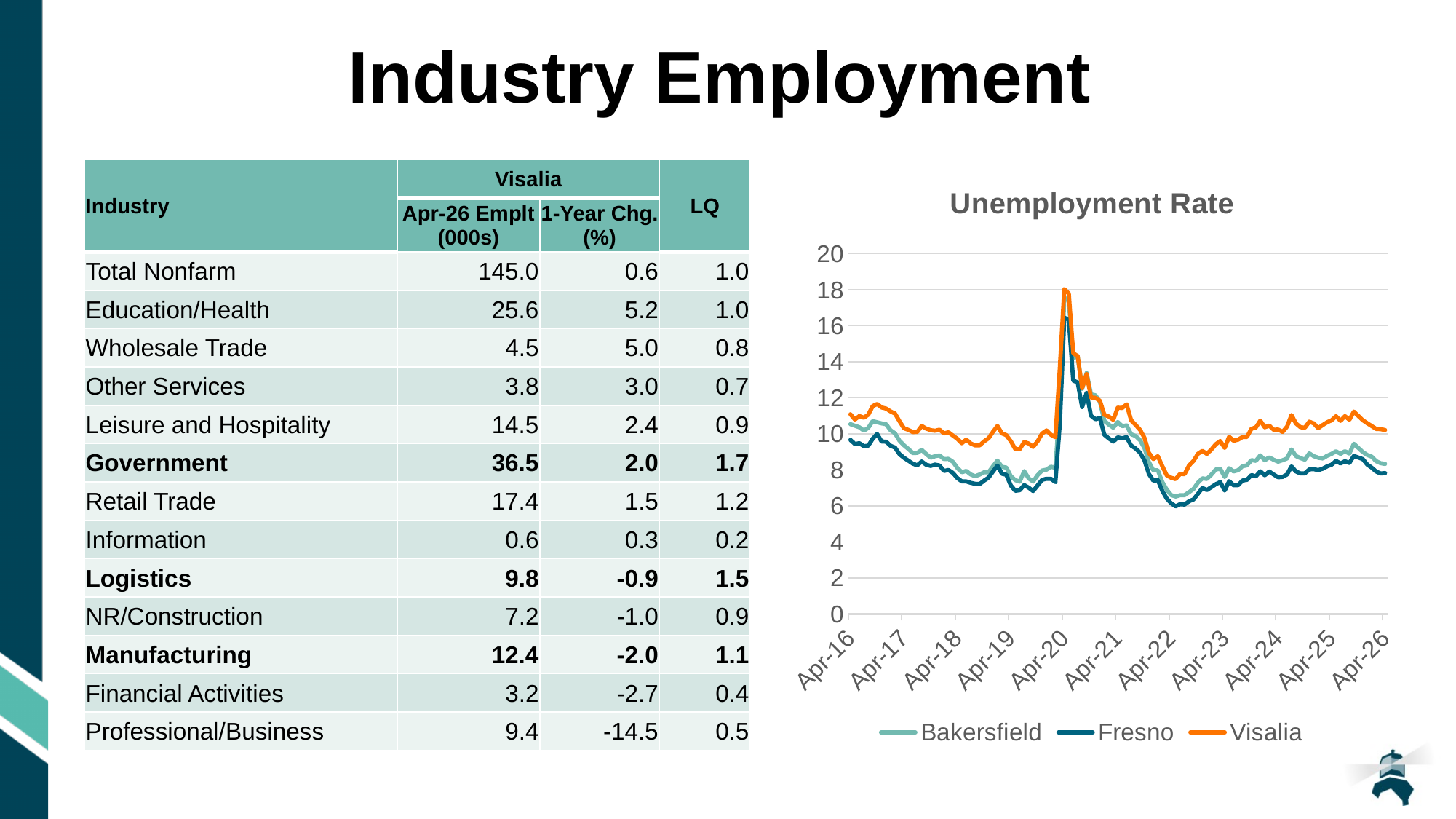
What is the title of the chart on the right of the slide? Unemployment Rate In the Unemployment Rate chart, which series has the highest value at Apr-26? Visalia Which series are listed in the legend of the Unemployment Rate chart? Bakersfield, Fresno, Visalia In the Unemployment Rate chart, is the value for Fresno at Apr-22 greater or less than 8? less In the Unemployment Rate chart, do the values rise or fall between the Apr-20 peak and Apr-22? fall How many date labels are shown on the x axis of the Unemployment Rate chart? 11 How many series does the legend of the Unemployment Rate chart list? 3 What kind of chart is the Unemployment Rate chart? line chart In the Unemployment Rate chart, which series has the lowest value at Apr-17? Fresno In the Unemployment Rate chart, is the value for Bakersfield at Apr-26 greater or less than 10? less In the Unemployment Rate chart, is the peak value for Visalia around Apr-20 greater or less than 16? greater In the Unemployment Rate chart, which series reaches the highest peak around Apr-20? Visalia